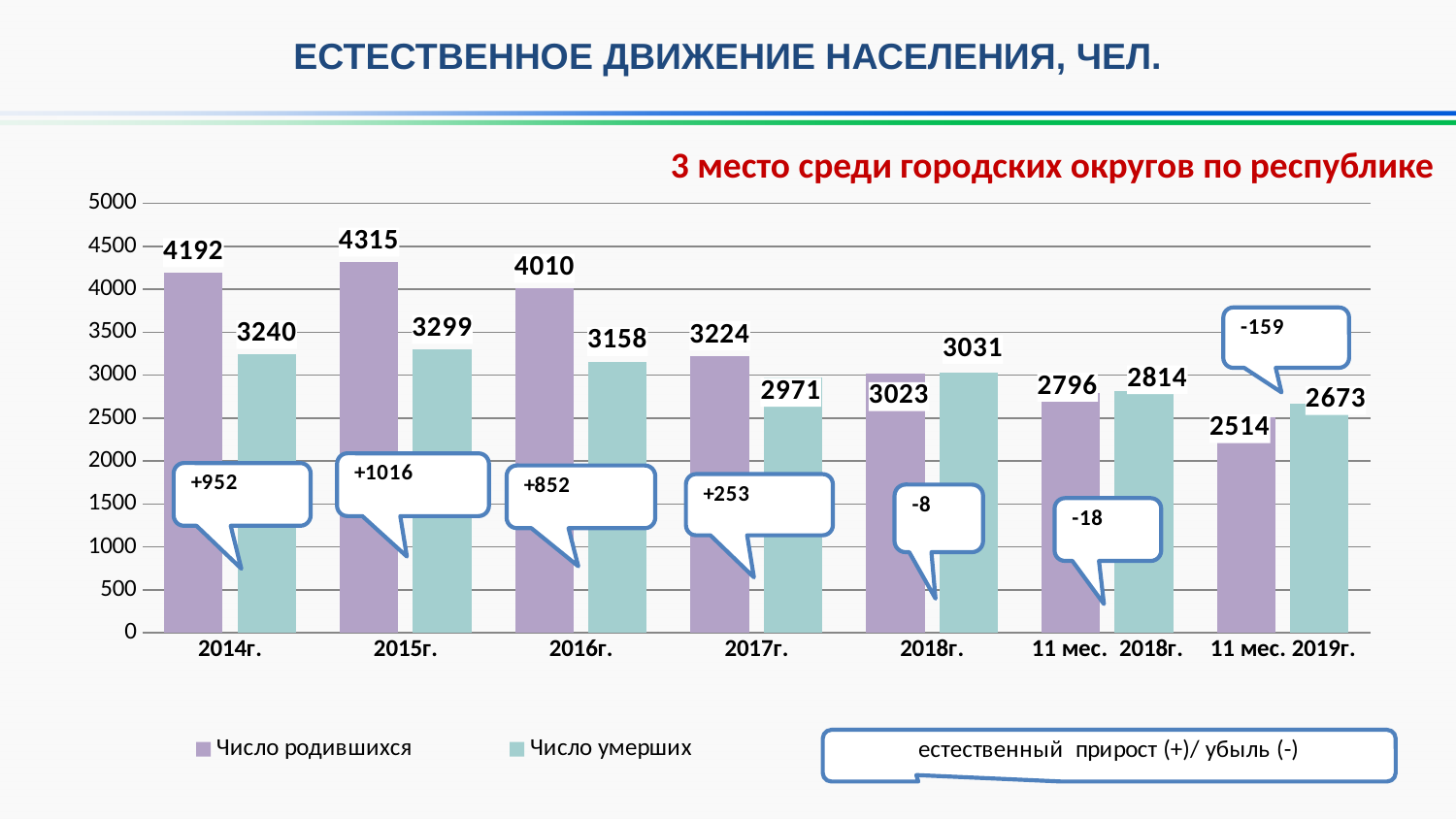
Do the values for Число родившихся rise or fall from 2015г. to 11 мес. 2019г.? fall What is the difference between Число родившихся and Число умерших in 2014г.? 952 Which category has the highest value for Число родившихся? 2015г. Which is larger in 2016г., Число родившихся or Число умерших? Число родившихся What is the value of Число умерших for 2017г.? 2971 What type of chart is shown on the slide? bar chart How many categories are shown on the x axis? 7 What is the value of Число родившихся for 2015г.? 4315 Which category has the lowest value for Число умерших? 11 мес. 2019г. What is the value of Число родившихся for 11 мес. 2019г.? 2514 How many series does the legend list? 2 What natural increase/decrease value is shown in the callout for 11 мес. 2019г.? -159